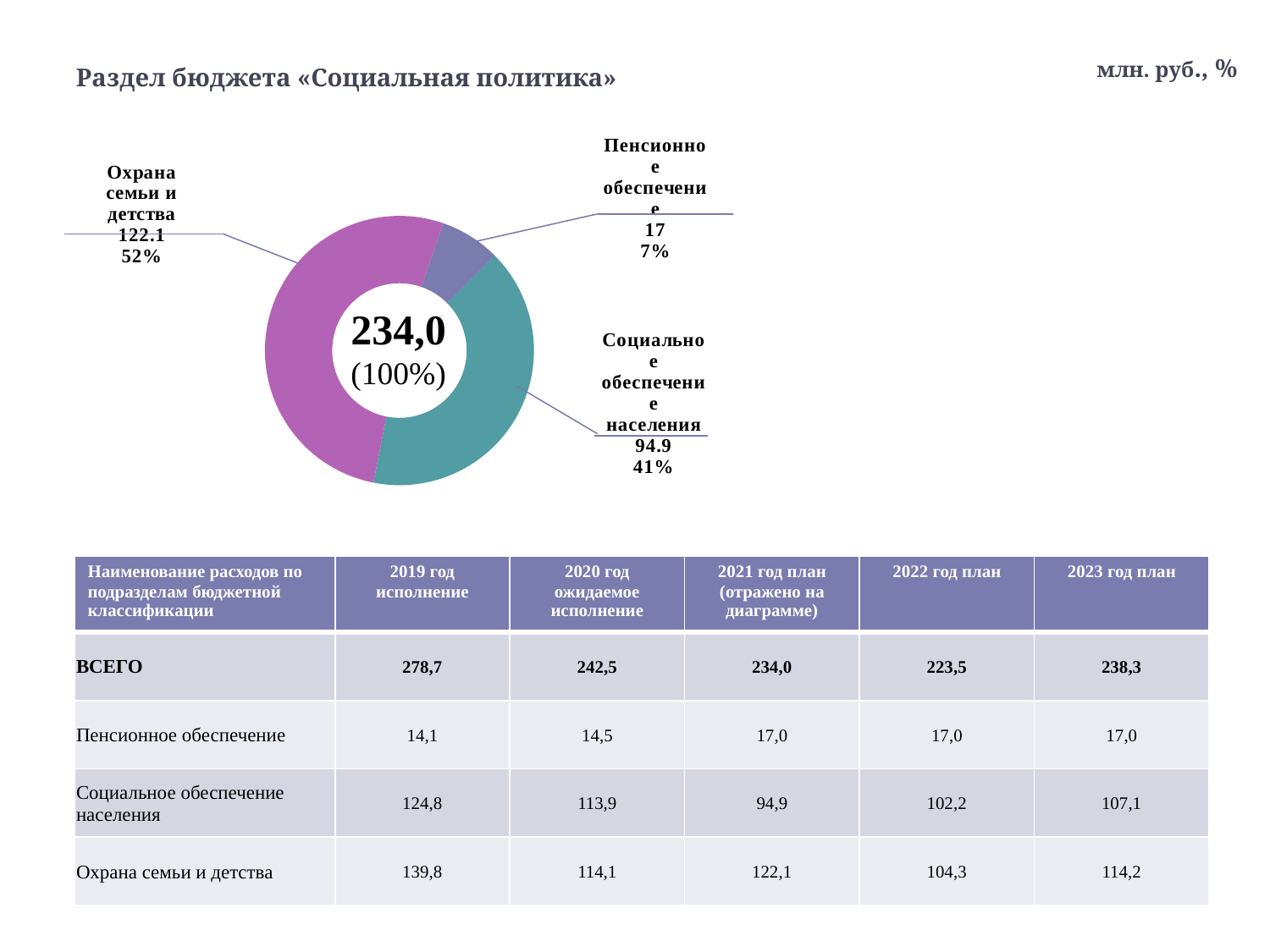
How many slices does the doughnut chart have? 3 Which category has the smallest slice in the chart? Пенсионное обеспечение What is the difference between the values for Охрана семьи и детства and Социальное обеспечение населения on the chart? 27.2 Which is larger on the chart: Социальное обеспечение населения or Пенсионное обеспечение? Социальное обеспечение населения Which category has the largest slice in the chart? Охрана семьи и детства What value is shown for Охрана семьи и детства on the chart? 122.1 What value is shown for Социальное обеспечение населения on the chart? 94.9 What value is shown for Пенсионное обеспечение on the chart? 17 What total value is shown in the centre of the doughnut chart? 234,0 What kind of chart is shown on the slide? Doughnut (pie) chart What share of the chart does Охрана семьи и детства represent? 52% What share of the chart does Пенсионное обеспечение represent? 7%